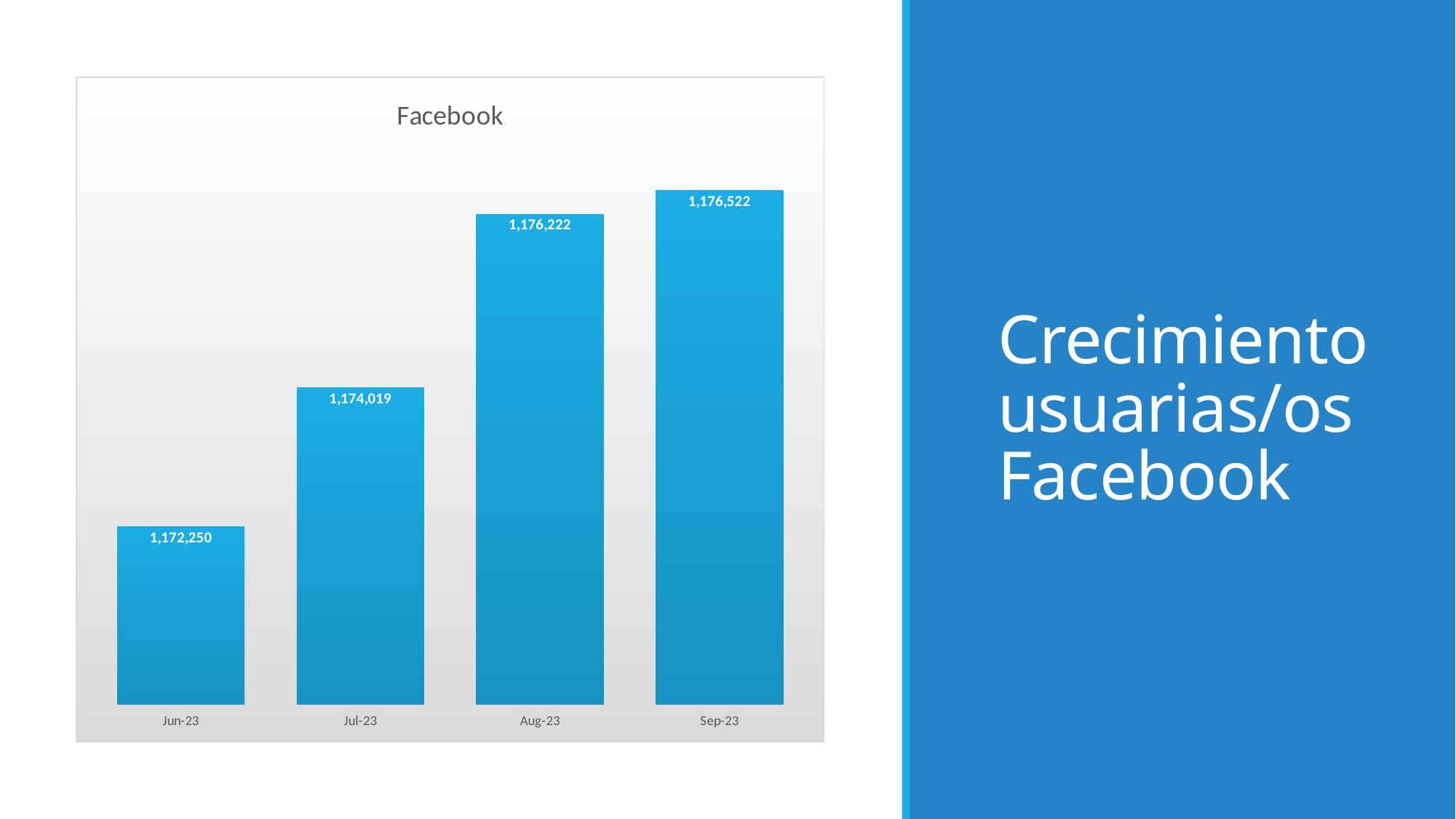
What is the value for Jun-23? 1,172,250 Which month has the lowest value? Jun-23 Which is larger, the value for Jul-23 or the value for Aug-23? Aug-23 What is the difference between the values for Sep-23 and Jun-23? 4,272 How many months are shown on the chart? 4 Do the values rise or fall from Jun-23 to Sep-23? Rise What is the value for Sep-23? 1,176,522 What is the value for Aug-23? 1,176,222 What kind of chart is shown on the slide? Bar chart Which month has the highest value? Sep-23 What is the difference between the values for Jul-23 and Jun-23? 1,769 What is the value for Jul-23? 1,174,019